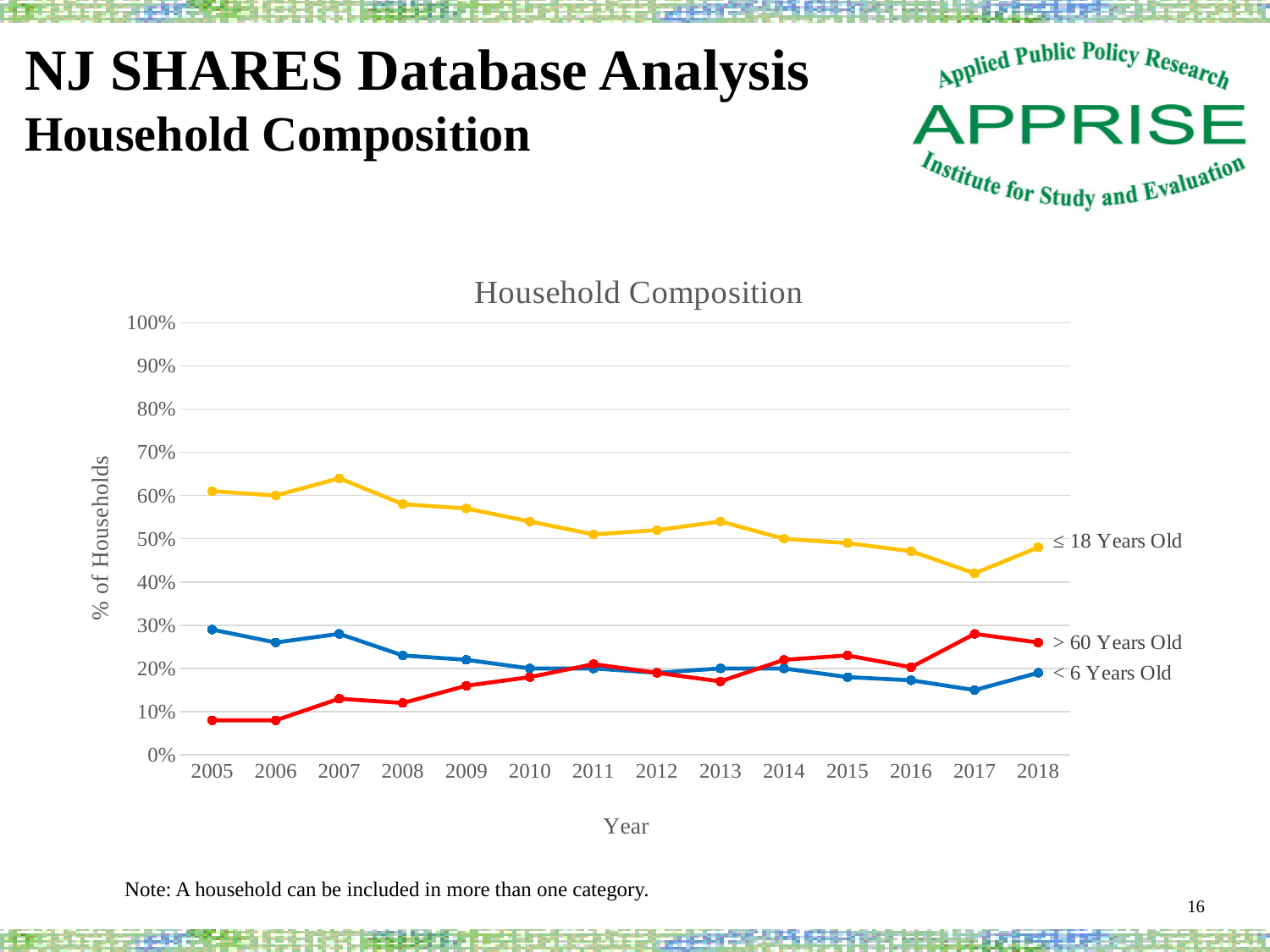
What is the label on the y axis of the chart? % of Households Is the value for > 60 Years Old in 2005 greater or less than 10%? less In which year is the ≤ 18 Years Old series at its lowest? 2017 Is the value for < 6 Years Old in 2017 greater or less than 20%? less Does the > 60 Years Old series rise or fall overall from 2005 to 2018? rise Does the ≤ 18 Years Old series rise or fall overall from 2005 to 2018? fall In which year is the ≤ 18 Years Old series at its highest? 2007 Is the value for ≤ 18 Years Old in 2005 greater or less than 50%? greater What kind of chart is shown on the slide? line chart How many series are plotted in the Household Composition chart? 3 How many years are shown on the x axis of the chart? 14 In 2018, which series has the larger value: > 60 Years Old or < 6 Years Old? > 60 Years Old